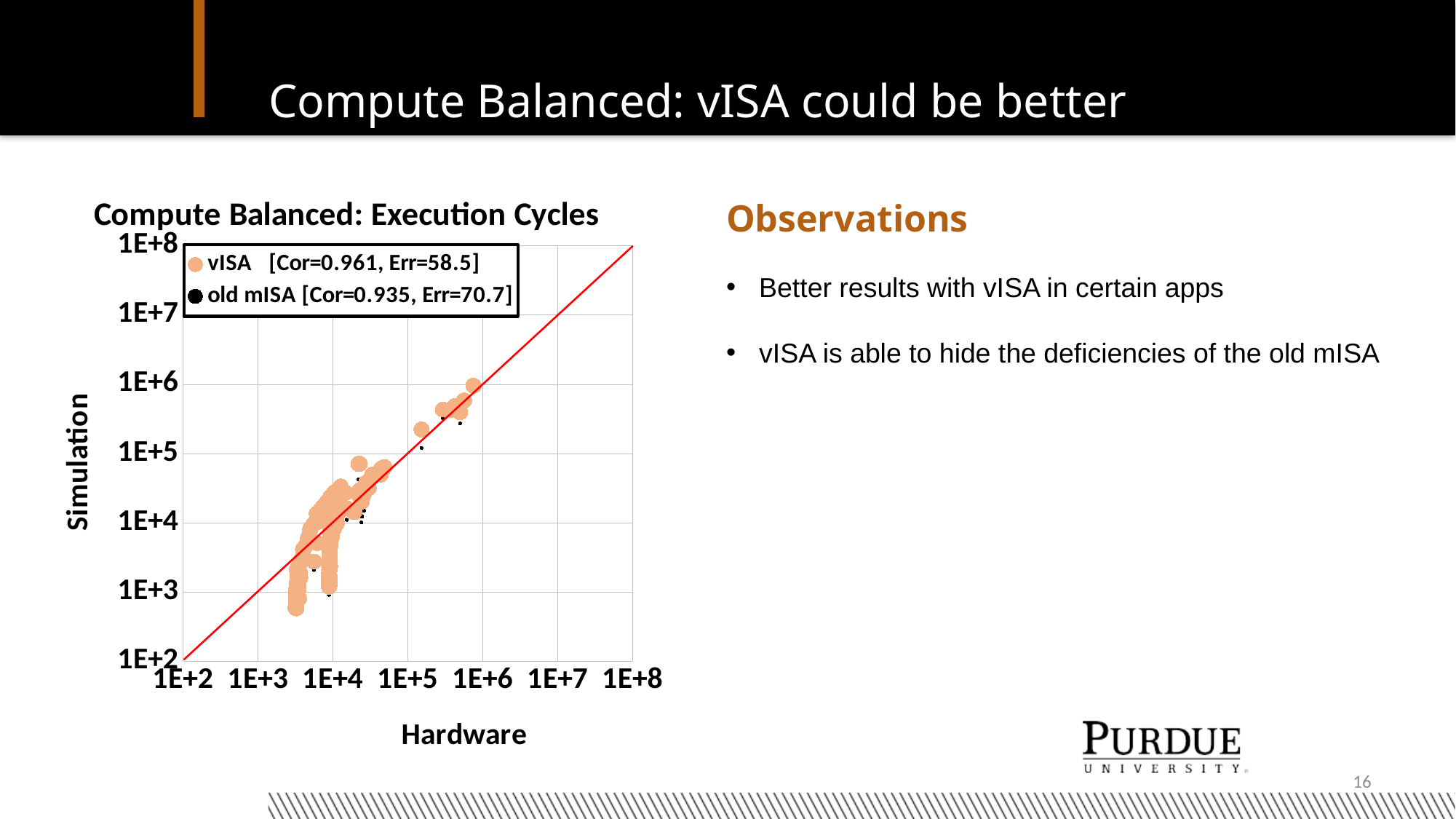
What is the title of the chart? Compute Balanced: Execution Cycles How many series does the legend of the chart list? 2 Which series has the higher correlation value in the legend, vISA or old mISA? vISA Is the Simulation value of the highest vISA point greater or less than 1E+7? less What is the label of the x axis of the chart? Hardware What is the difference between the Err values of old mISA and vISA shown in the legend? 12.2 Which series has the higher Err value in the legend, vISA or old mISA? old mISA What kind of chart is shown on the slide? scatter chart What correlation (Cor) value is given for vISA in the legend? 0.961 What error (Err) value is given for old mISA in the legend? 70.7 What is the difference between the Cor values of vISA and old mISA shown in the legend? 0.026 Do the Simulation values of the plotted points rise or fall as the Hardware value increases along the x axis? rise